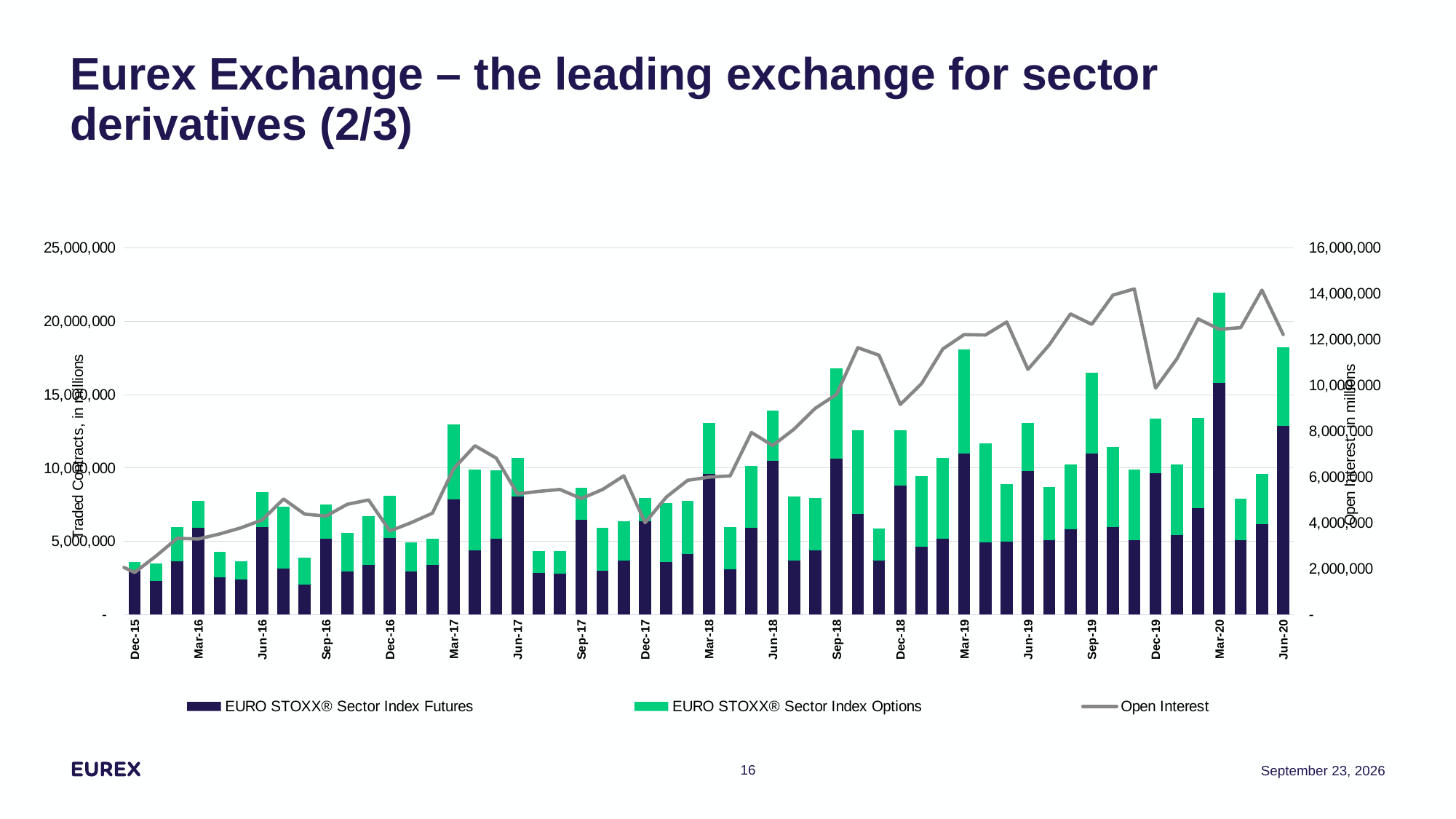
What is the title of the right-hand vertical axis? Open Interest, in millions Which month has the larger total traded contracts, Mar-18 or Mar-19? Mar-19 Is the total traded contracts for Mar-20 greater or less than 20,000,000? greater How many series does the legend list? 3 Is the total traded contracts for Jun-20 greater or less than 15,000,000? greater Which month has the larger total traded contracts, Mar-20 or Jun-20? Mar-20 Does the Open Interest line generally rise or fall from Dec-15 to Jun-20? rise Is the total traded contracts for Dec-15 greater or less than 5,000,000? less What kind of chart is shown on the slide? A stacked bar chart combined with a line Which month has the highest total traded contracts (tallest stacked bar)? Mar-20